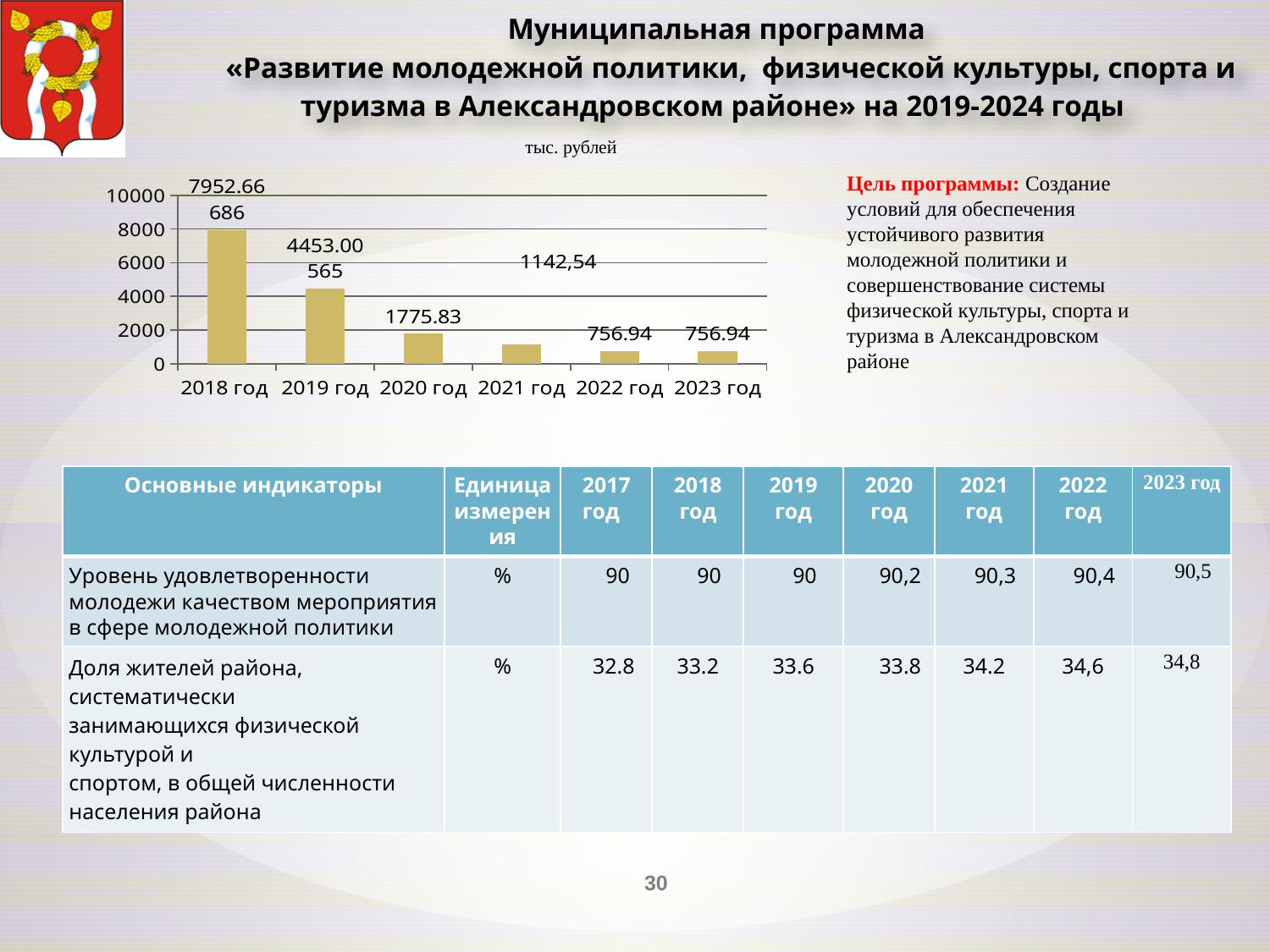
Which is larger, the value for 2020 год or the value for 2021 год? 2020 год What is the value for 2020 год in the chart? 1775.83 Is the value for 2019 год greater or less than 4000? greater What is the value for 2018 год in the chart? 7952.66 How many years are shown on the x axis of the chart? 6 What is the difference between the values for 2018 год and 2019 год? 3499.66 What kind of chart is shown on the slide? bar chart Which year has the highest value in the chart? 2018 год What is the value for 2019 год in the chart? 4453.00 In what units are the chart values given, according to the label above the chart? тыс. рублей What is the value for 2022 год in the chart? 756.94 Do the values in the chart generally rise or fall from 2018 год to 2023 год? fall